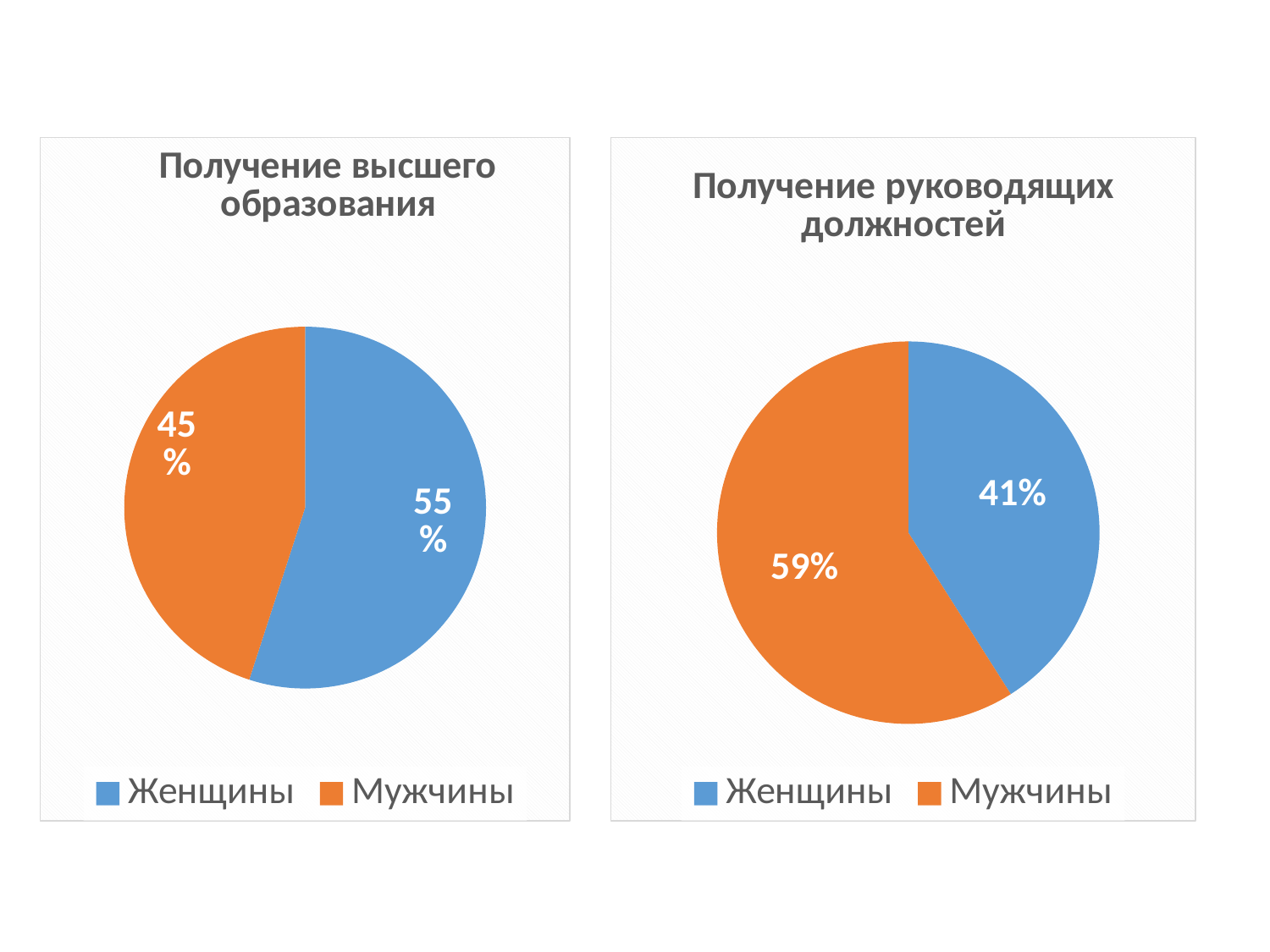
In the chart titled "Получение высшего образования", what share of the pie is Женщины? 55% In the chart titled "Получение руководящих должностей", which is larger: Женщины or Мужчины? Мужчины In the chart titled "Получение высшего образования", what colour is the Мужчины slice? Orange In the chart titled "Получение руководящих должностей", which category has the smallest slice? Женщины What kind of chart is the left chart on the slide? Pie chart In the chart titled "Получение высшего образования", which category has the largest slice? Женщины How many categories does the legend of the right chart list? 2 In the chart titled "Получение руководящих должностей", what share of the pie is Мужчины? 59% In the chart titled "Получение высшего образования", what is the difference between the Женщины and Мужчины shares? 10% In the chart titled "Получение высшего образования", what share of the pie is Мужчины? 45% In the chart titled "Получение руководящих должностей", what is the difference between the Мужчины and Женщины shares? 18%